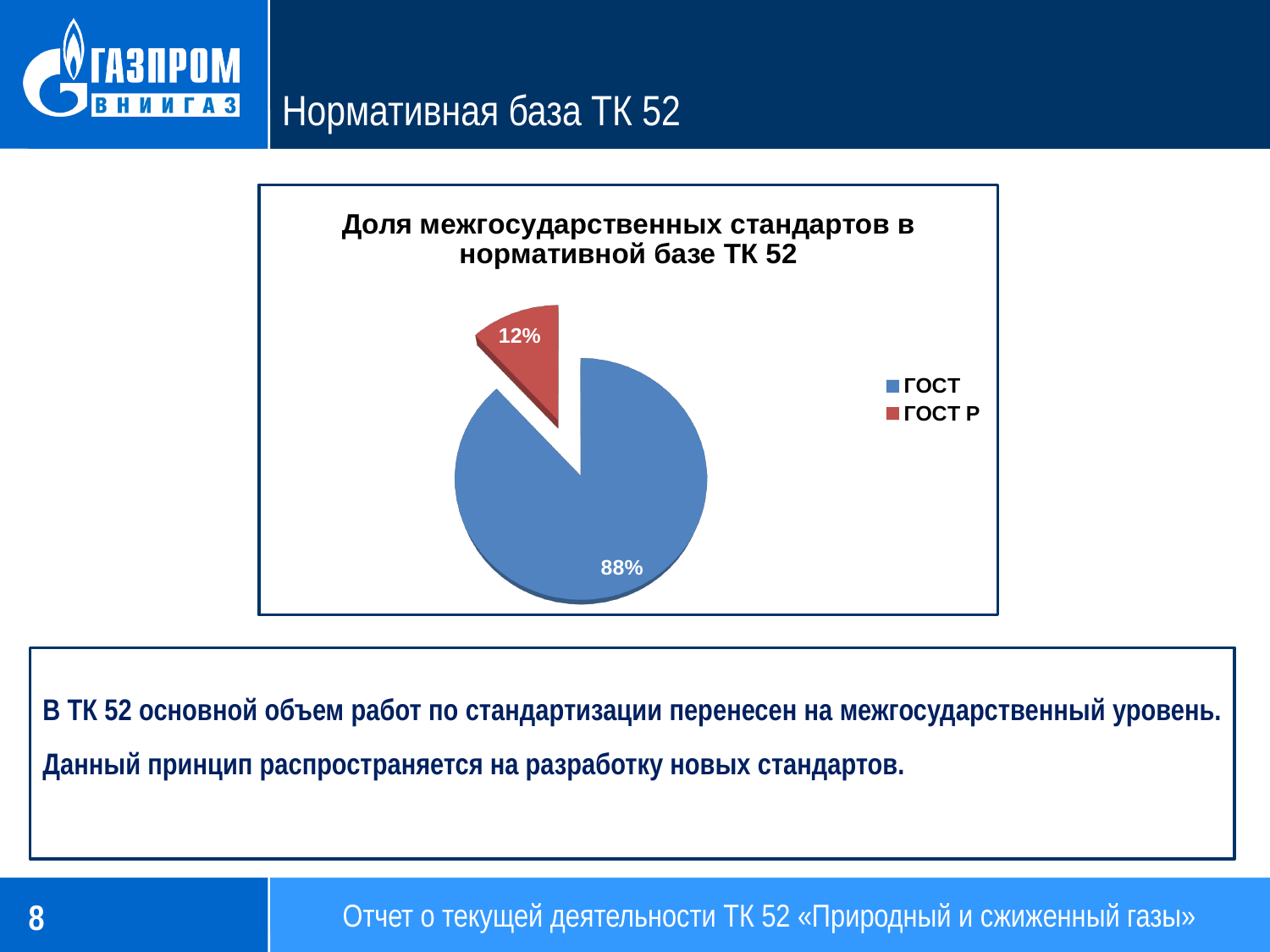
Which category has the smallest slice of the pie? ГОСТ Р Which is larger, the ГОСТ slice or the ГОСТ Р slice? ГОСТ What colour is the ГОСТ Р slice? Red How many entries does the legend list? 2 What is the title of the chart? Доля межгосударственных стандартов в нормативной базе ТК 52 How many slices does the pie chart have? 2 Which category has the largest slice of the pie? ГОСТ What share of the pie does ГОСТ hold? 88% What kind of chart is shown on the slide? Pie chart What share of the pie does ГОСТ Р hold? 12% What is the difference in percentage points between the ГОСТ and ГОСТ Р slices? 76